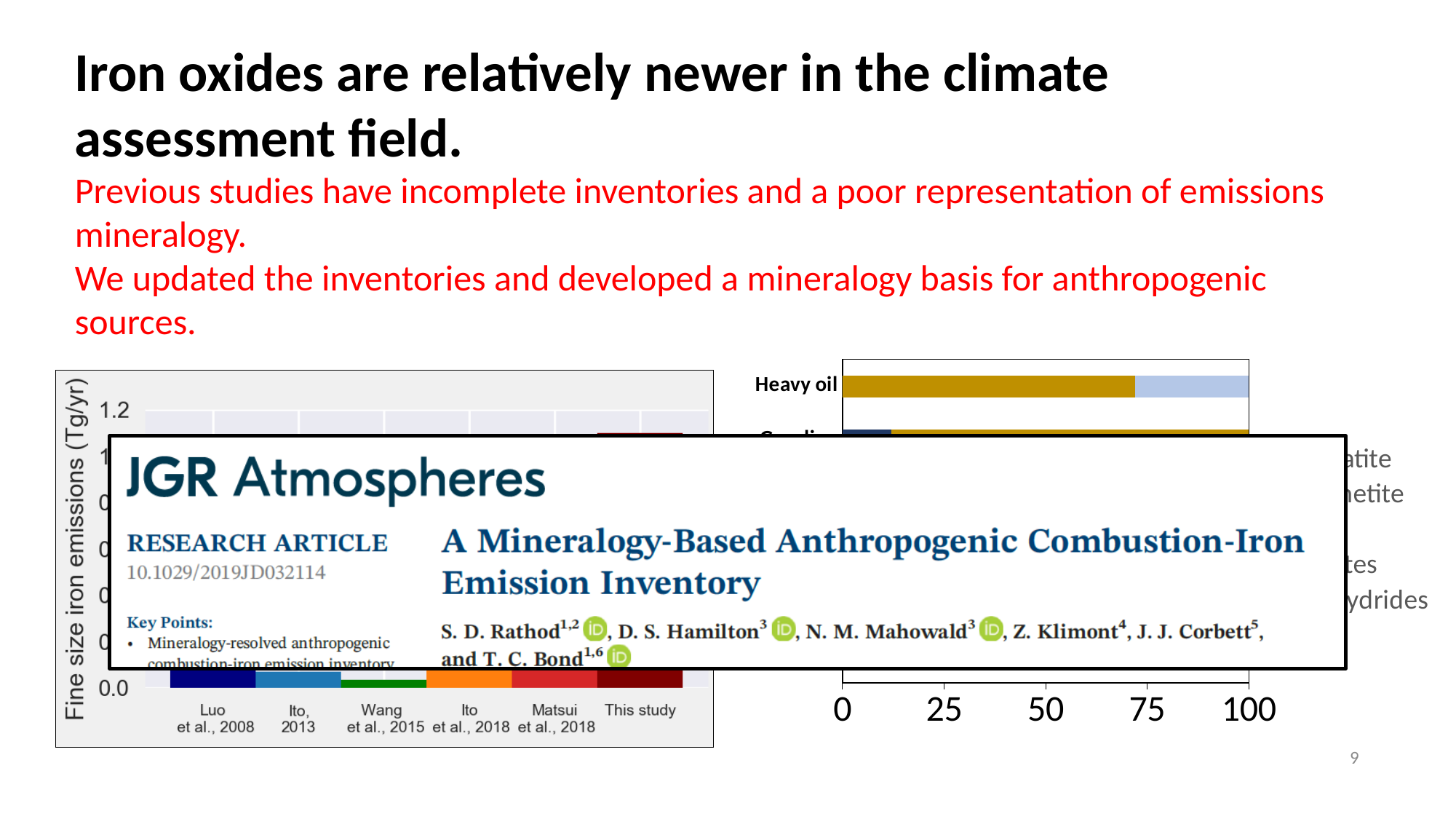
How many categories (studies) are shown along the x axis of the left chart? 6 What is the highest tick value shown on the y axis of the left chart? 1.2 What kind of chart is the chart on the left of the slide (with the y axis 'Fine size iron emissions (Tg/yr)')? bar chart What is the label of the y axis on the left chart? Fine size iron emissions (Tg/yr) Which category is the last (rightmost) on the x axis of the left chart? This study On the right chart, is the value of the first (gold) segment of the Heavy oil bar greater or less than 25? greater On the right chart, what is the highest tick value shown on the x axis? 100 What kind of chart is the chart on the right of the slide (with the 'Heavy oil' category)? bar chart On the right chart, is the value of the first (gold) segment of the Heavy oil bar greater or less than 50? greater